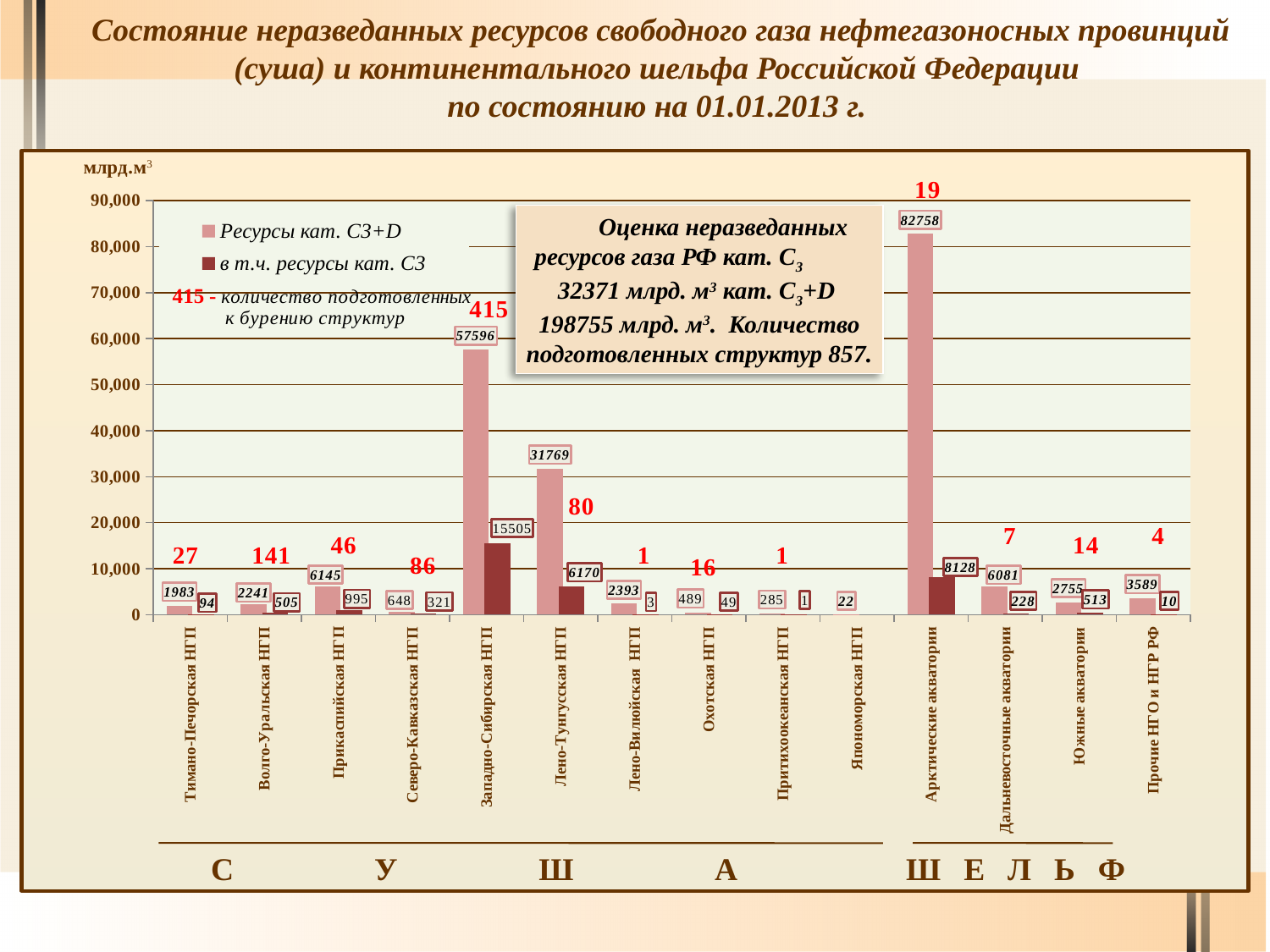
What is the value of 'Ресурсы кат. С3+D' for Лено-Тунгусская НГП? 31769 How many categories are shown on the x axis of the chart? 14 What is the value of 'Ресурсы кат. С3+D' for Арктические акватории? 82758 Which category has the lowest value of 'Ресурсы кат. С3+D'? Япономорская НГП How many series does the legend list? 2 What kind of chart is shown on the slide? bar chart What is the red number of prepared structures shown above the Волго-Уральская НГП bars? 141 Which category has the highest value of 'Ресурсы кат. С3+D'? Арктические акватории Is the 'Ресурсы кат. С3+D' value for Западно-Сибирская НГП greater or less than 50,000? greater Which is larger: the 'Ресурсы кат. С3+D' value for Прикаспийская НГП or for Дальневосточные акватории? Прикаспийская НГП What is the value of 'в т.ч. ресурсы кат. С3' for Западно-Сибирская НГП? 15505 What is the difference between the 'Ресурсы кат. С3+D' values for Арктические акватории and Западно-Сибирская НГП? 25162